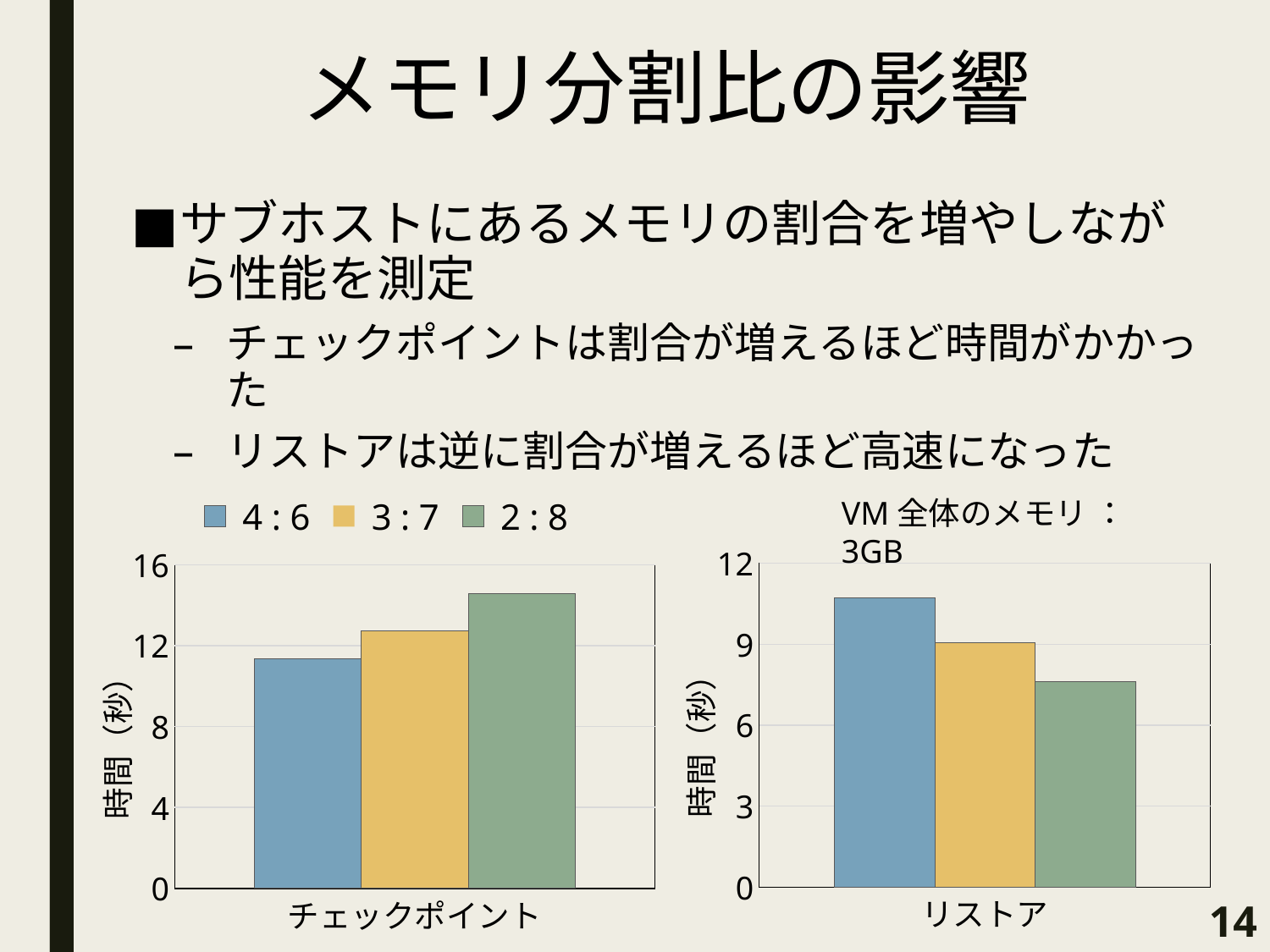
In the リストア chart, which is larger, the value for 4 : 6 or the value for 3 : 7? 4 : 6 What is the y-axis label of the リストア chart? 時間（秒） In the リストア chart, which memory ratio has the lowest value? 2 : 8 In the リストア chart, is the value for 2 : 8 greater or less than 9? less In the チェックポイント chart, which memory ratio has the highest value? 2 : 8 How many series does the legend list for the charts? 3 In the リストア chart, do the values rise or fall going from 4 : 6 to 3 : 7 to 2 : 8? fall In the チェックポイント chart, which memory ratio has the lowest value? 4 : 6 In the チェックポイント chart, do the values rise or fall going from 4 : 6 to 3 : 7 to 2 : 8? rise In the チェックポイント chart, is the value for 2 : 8 greater or less than 12? greater In the リストア chart, which memory ratio has the highest value? 4 : 6 What kind of chart is the チェックポイント chart on the left? bar chart